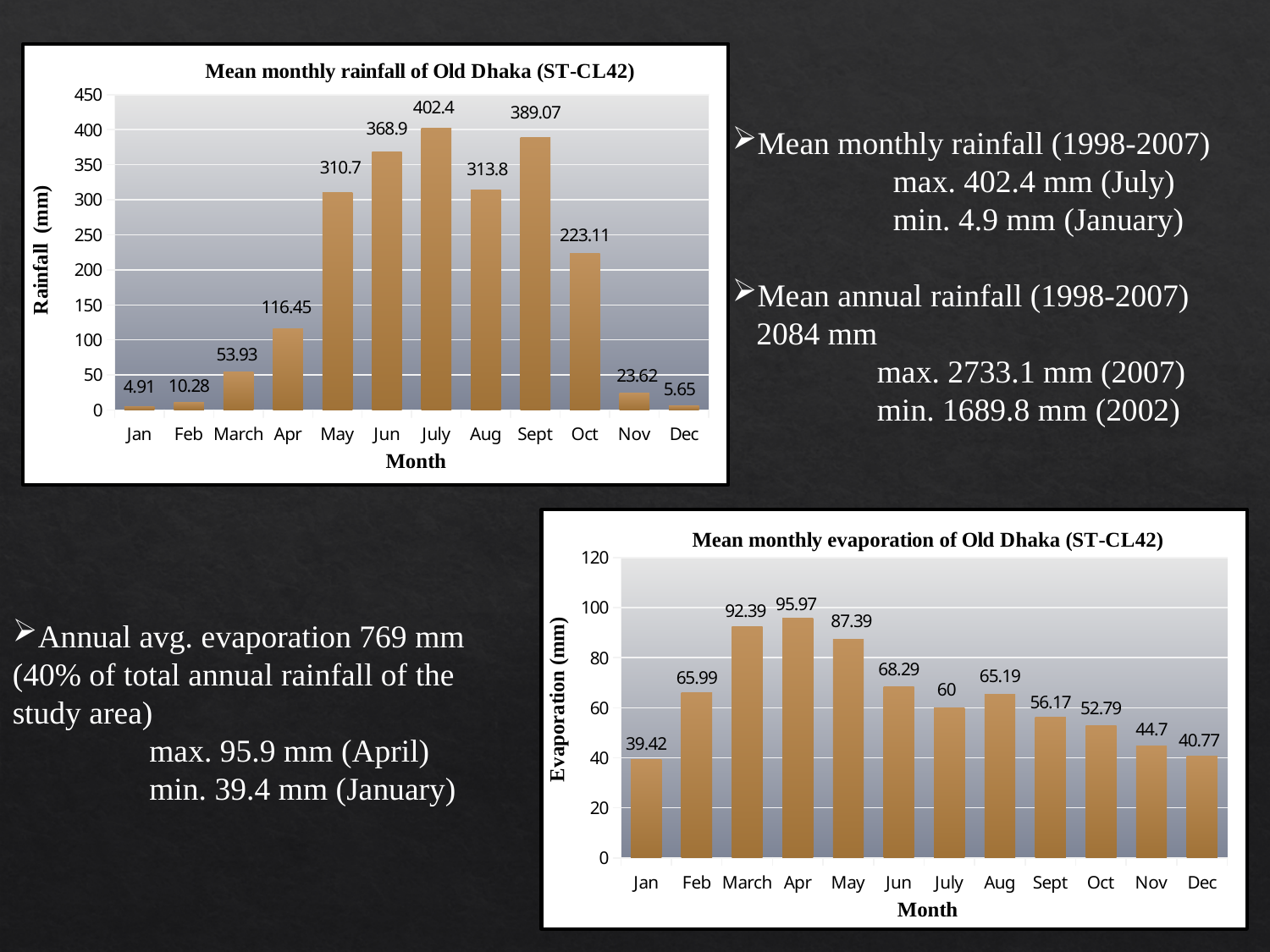
In the 'Mean monthly rainfall of Old Dhaka (ST-CL42)' chart, what is the rainfall value for July? 402.4 In the 'Mean monthly rainfall of Old Dhaka (ST-CL42)' chart, what is the rainfall value for Oct? 223.11 In the 'Mean monthly evaporation of Old Dhaka (ST-CL42)' chart, which month has the highest evaporation? Apr In the 'Mean monthly evaporation of Old Dhaka (ST-CL42)' chart, what is the evaporation value for March? 92.39 In the 'Mean monthly evaporation of Old Dhaka (ST-CL42)' chart, what is the label of the y axis? Evaporation (mm) In the 'Mean monthly rainfall of Old Dhaka (ST-CL42)' chart, how many months are shown on the x axis? 12 In the 'Mean monthly rainfall of Old Dhaka (ST-CL42)' chart, which is larger, the rainfall for Sept or for Aug? Sept What kind of chart is the 'Mean monthly evaporation of Old Dhaka (ST-CL42)' chart? Bar chart In the 'Mean monthly evaporation of Old Dhaka (ST-CL42)' chart, is the value for Sept greater or less than 60? less In the 'Mean monthly rainfall of Old Dhaka (ST-CL42)' chart, which month has the lowest rainfall? Jan In the 'Mean monthly evaporation of Old Dhaka (ST-CL42)' chart, what is the difference between the Apr and Jan evaporation values? 56.55 In the 'Mean monthly rainfall of Old Dhaka (ST-CL42)' chart, what is the difference between the July and Jun rainfall values? 33.5